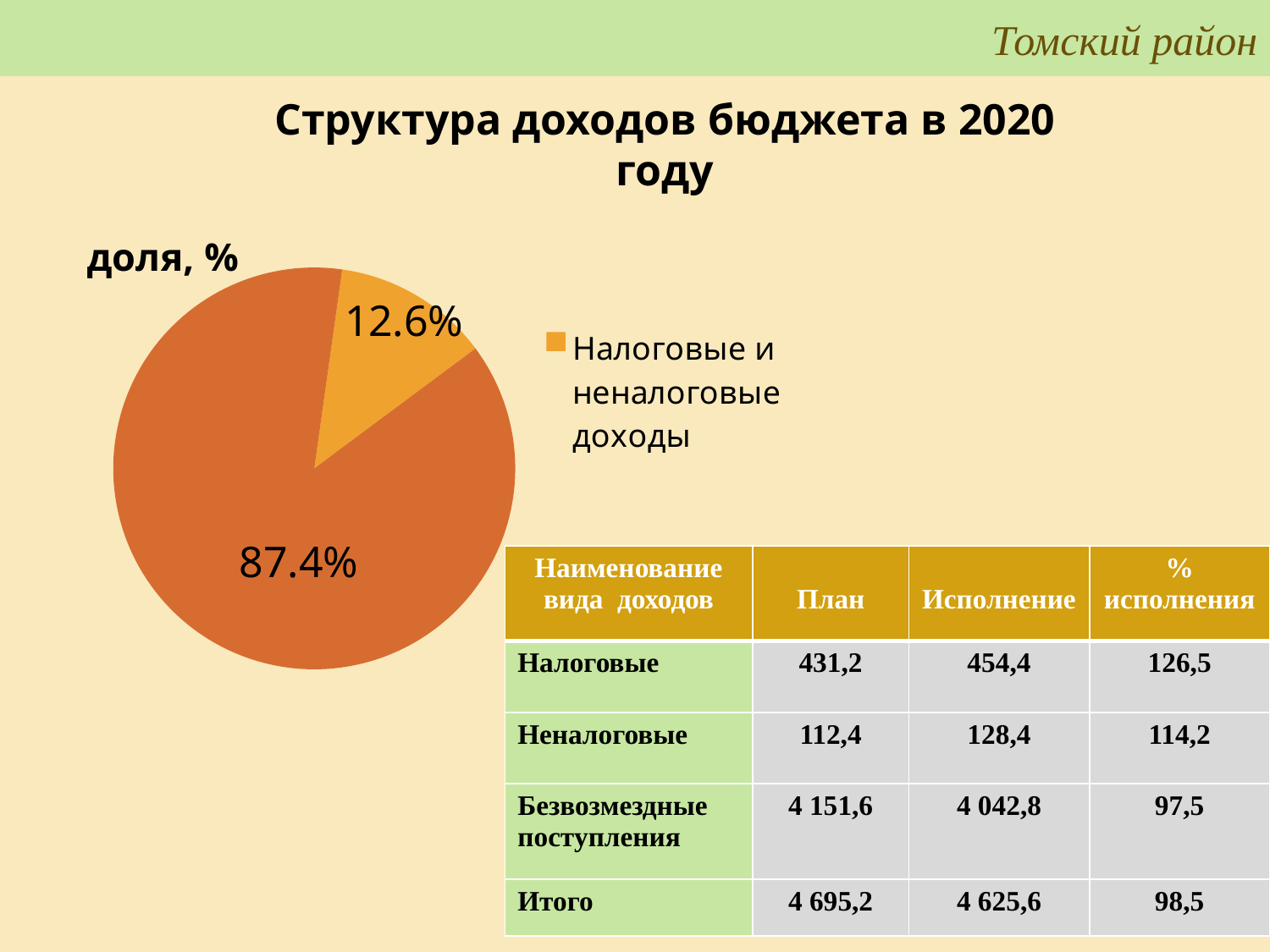
What is the difference in percentage points between the two slices of the pie chart (87.4% and 12.6%)? 74.8 Is the share for "Налоговые и неналоговые доходы" greater or less than 50%? less What kind of chart is shown on the slide? Pie chart Which slice is larger: the one labelled 12.6% or the one labelled 87.4%? The one labelled 87.4% What do the two slices of the pie chart add up to? 100% What is the value shown on the smallest slice of the pie chart? 12.6% Which legend entry is readable next to the pie chart? Налоговые и неналоговые доходы What is the title of the pie chart? доля, % What is the value shown on the largest slice of the pie chart? 87.4% What share of the pie does "Налоговые и неналоговые доходы" have? 12.6% How many slices does the pie chart have? 2